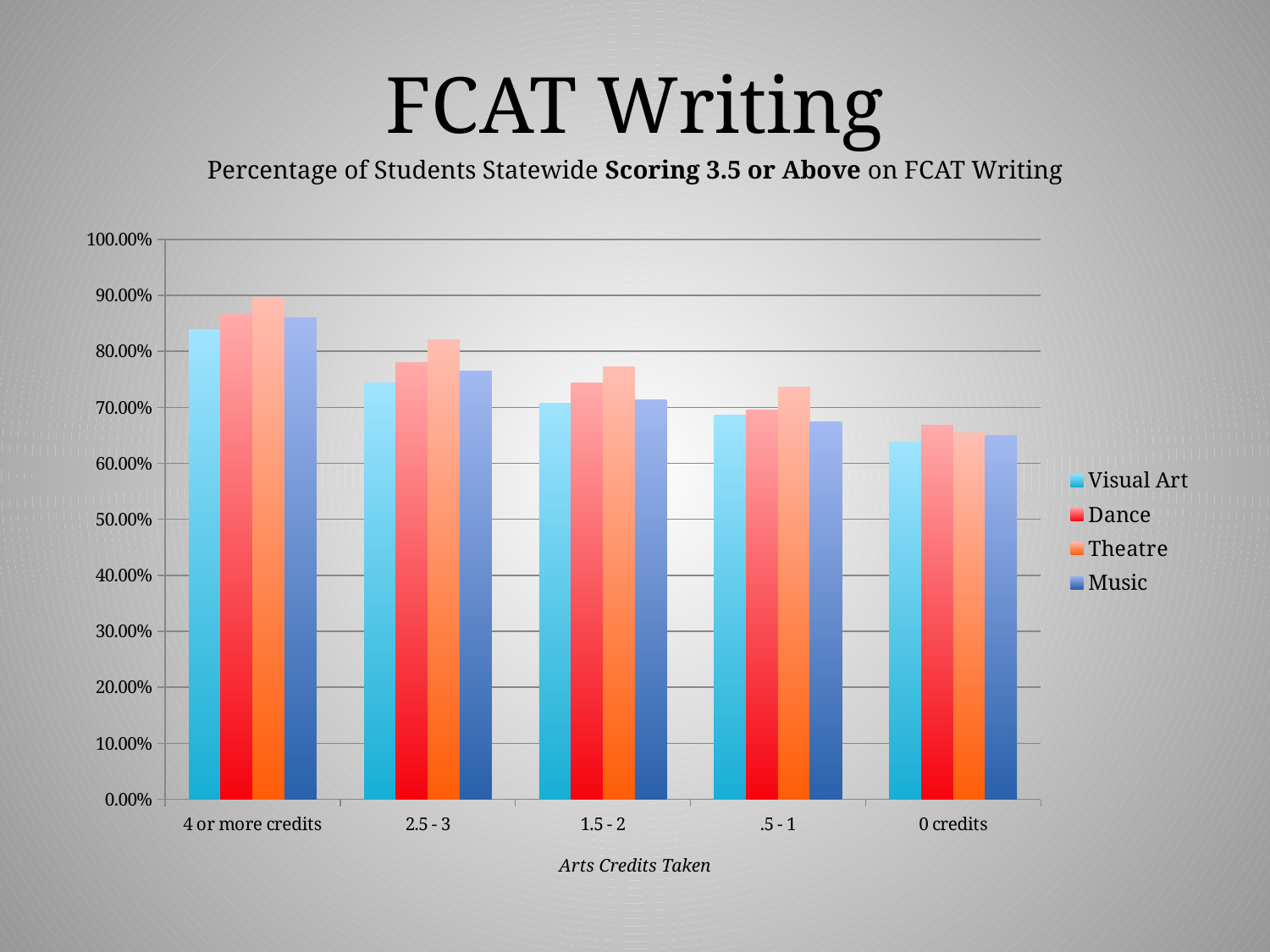
Is the Theatre value for '4 or more credits' greater or less than 80.00%? greater For the '2.5 - 3' category, which is larger: the Theatre value or the Visual Art value? Theatre Which category has the lowest Visual Art value? 0 credits How many series does the legend list? 4 Is the Music value for '1.5 - 2' greater or less than 80.00%? less How many categories are shown along the x axis? 5 Is the Visual Art value for '0 credits' greater or less than 70.00%? less Do the Visual Art values rise or fall moving from '4 or more credits' to '0 credits' along the x axis? fall What kind of chart is shown on the slide? bar chart What is the title of the x axis? Arts Credits Taken Which category has the highest Theatre value? 4 or more credits Within the '4 or more credits' category, which series has the highest value? Theatre